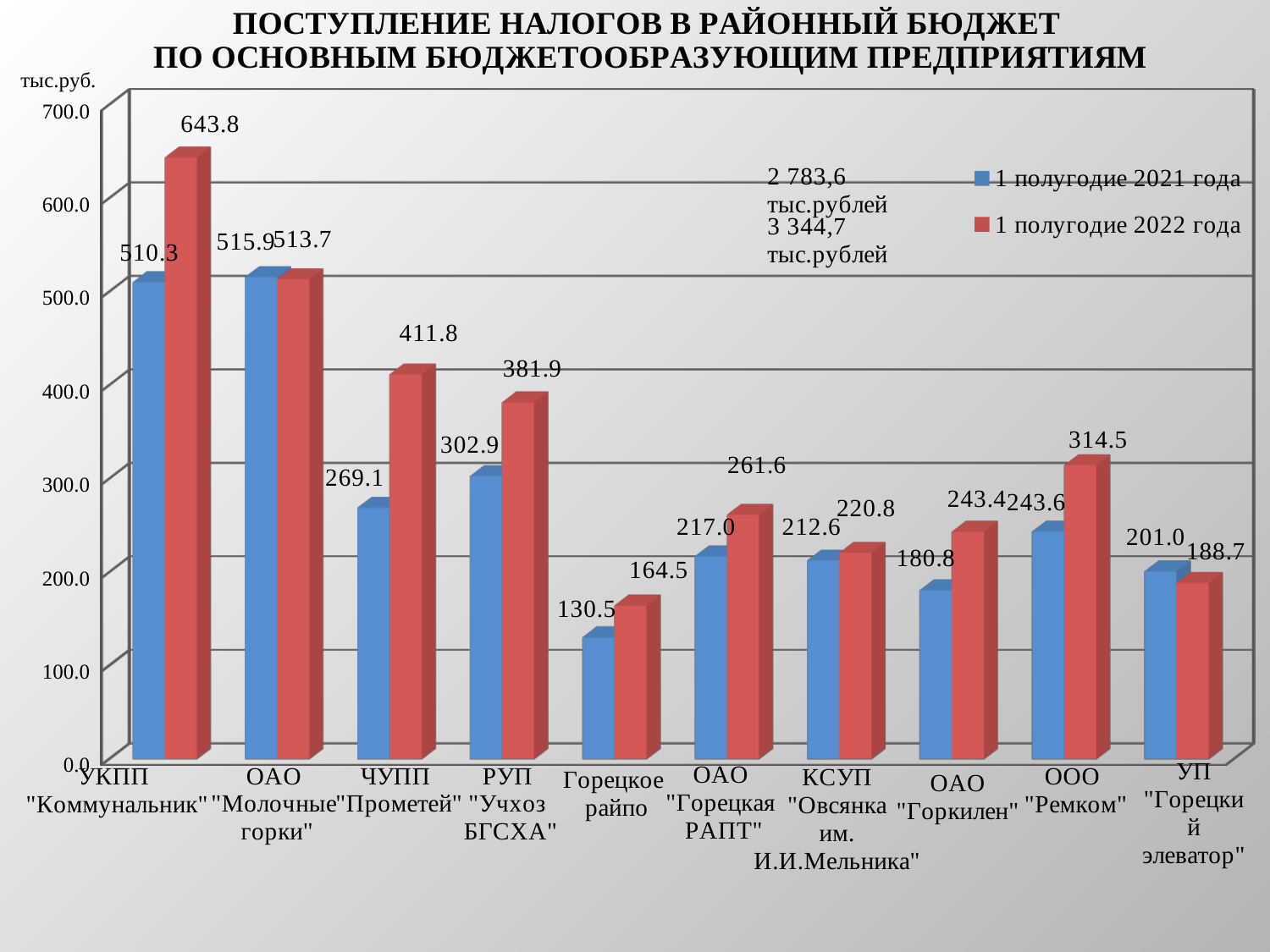
Is the value for ОАО "Горкилен" in the 1 полугодие 2022 года series greater or less than 200.0? greater How many categories (enterprises) are shown on the x axis? 10 What is the difference between the 1 полугодие 2022 года and 1 полугодие 2021 года values for ООО "Ремком"? 70.9 What unit is shown on the vertical axis label? тыс.руб. Which category has the lowest value in the 1 полугодие 2021 года series? Горецкое райпо What is the value for Горецкое райпо in the 1 полугодие 2022 года series? 164.5 What is the value for УКПП "Коммунальник" in the 1 полугодие 2022 года series? 643.8 What kind of chart is shown on the slide? Bar chart For УП "Горецкий элеватор", which series has the larger value: 1 полугодие 2021 года or 1 полугодие 2022 года? 1 полугодие 2021 года Which category has the highest value in the 1 полугодие 2022 года series? УКПП "Коммунальник" How many series does the legend list? 2 What is the value for ЧУПП "Прометей" in the 1 полугодие 2021 года series? 269.1